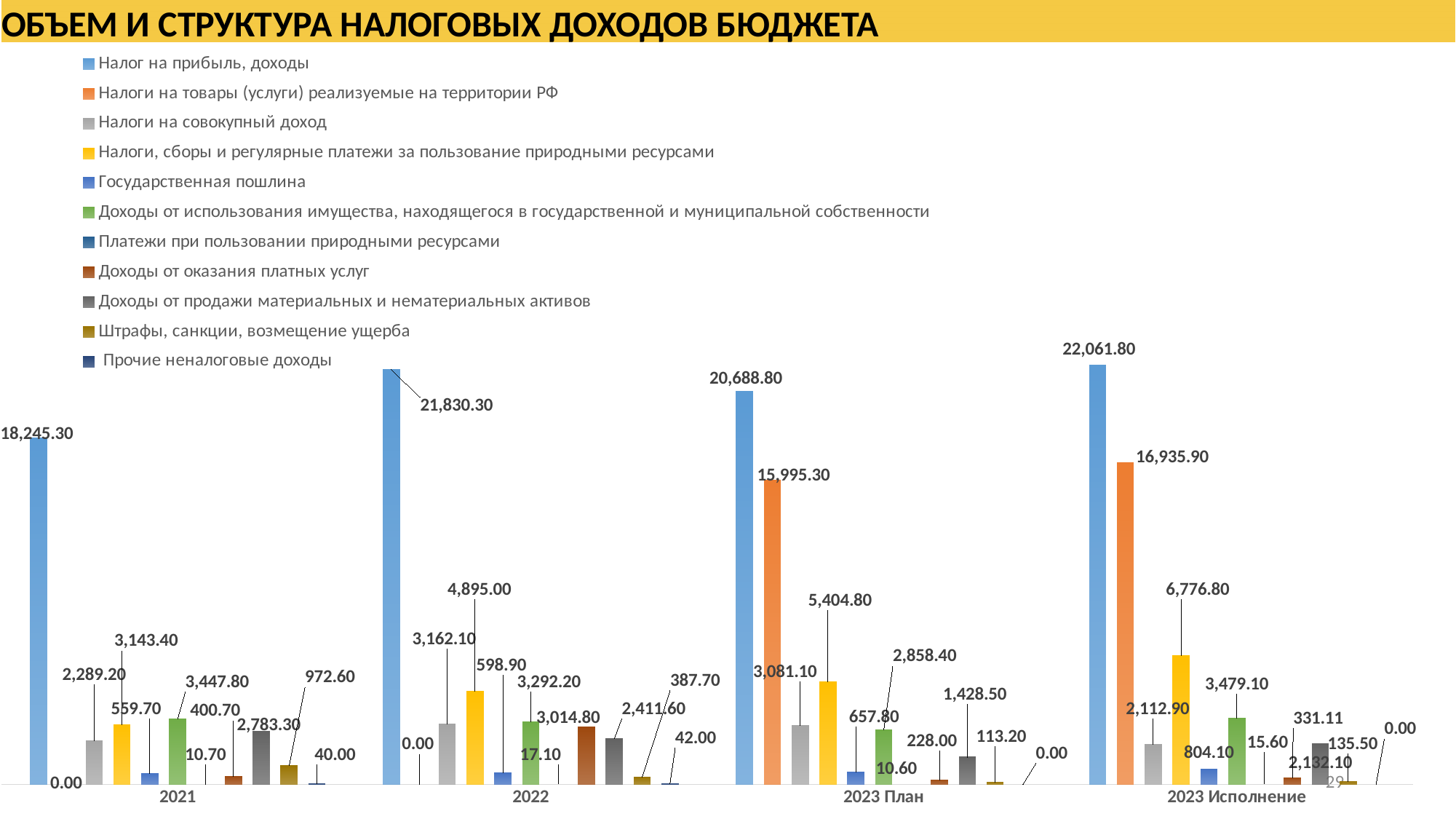
How many categories are shown on the x axis? 4 In which category is 'Налог на прибыль, доходы' the lowest? 2021 What is the value of 'Налоги на товары (услуги) реализуемые на территории РФ' for 2021? 0.00 What kind of chart is shown on the slide? Bar chart In which category is 'Налог на прибыль, доходы' the highest? 2023 Исполнение What is the value of 'Налоги, сборы и регулярные платежи за пользование природными ресурсами' for 2022? 4,895.00 How many series does the legend list? 11 Which is larger for 'Налоги на товары (услуги) реализуемые на территории РФ': 2023 План or 2023 Исполнение? 2023 Исполнение What is the difference between 'Налог на прибыль, доходы' for 2023 Исполнение and 2023 План? 1,373.00 What is the value of 'Налог на прибыль, доходы' for 2023 Исполнение? 22,061.80 Do the values of 'Налоги, сборы и регулярные платежи за пользование природными ресурсами' rise or fall from 2021 to 2023 Исполнение? Rise What is the value of 'Налоги на товары (услуги) реализуемые на территории РФ' for 2023 План? 15,995.30